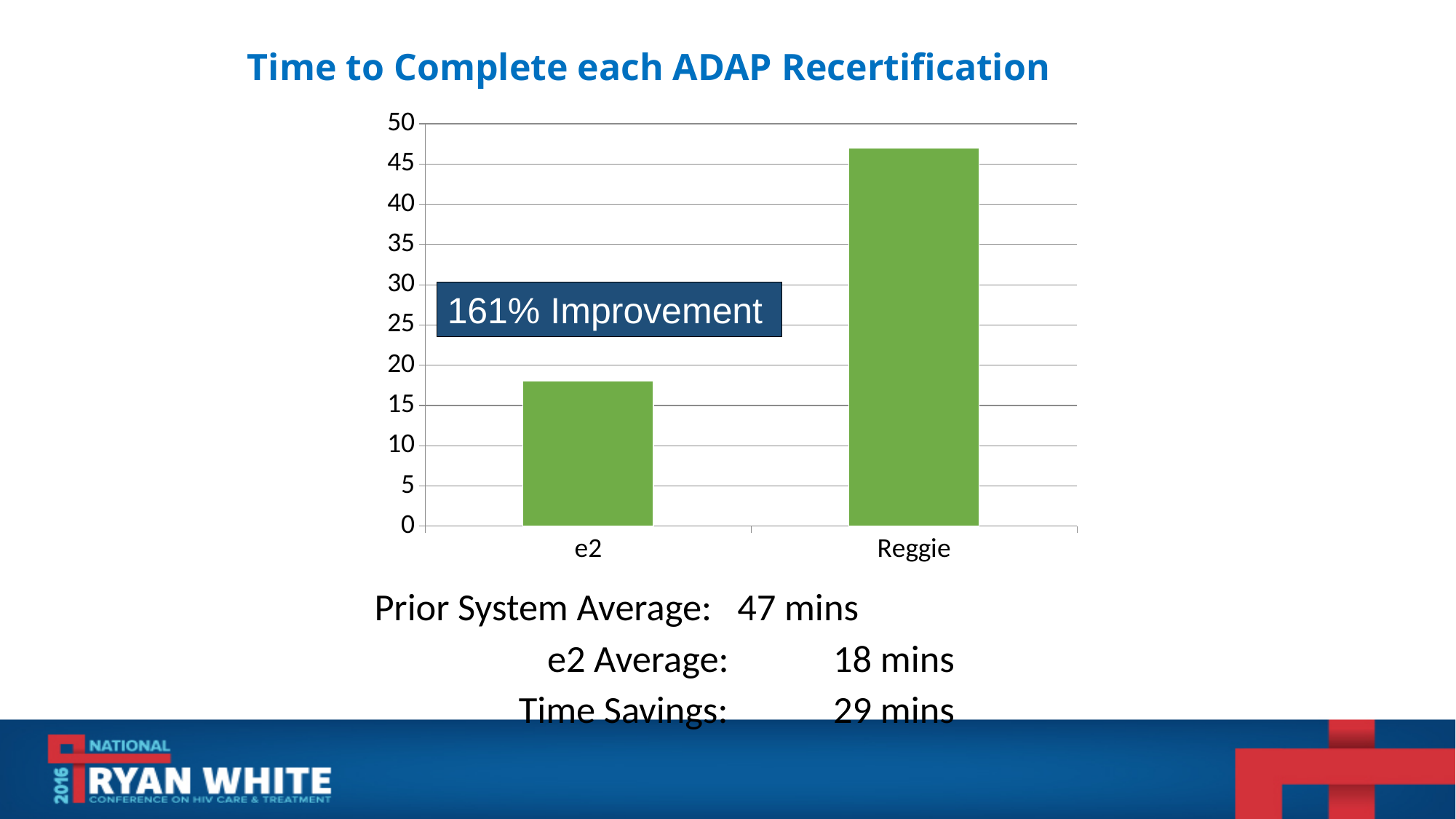
According to the text below the chart, what is the e2 average time? 18 mins What percentage improvement is stated in the box on the chart? 161% Which category has the highest bar in the chart? Reggie How many categories are plotted on the x axis of the chart? 2 Is the value for e2 greater or less than 15? greater What kind of chart is shown on the slide? bar chart What is the title of the chart? Time to Complete each ADAP Recertification Which bar is taller, e2 or Reggie? Reggie Which category has the lowest bar in the chart? e2 Is the value for Reggie greater or less than 40? greater Is the value for e2 greater or less than 20? less According to the text below the chart, what is the time savings between the prior system and e2? 29 mins